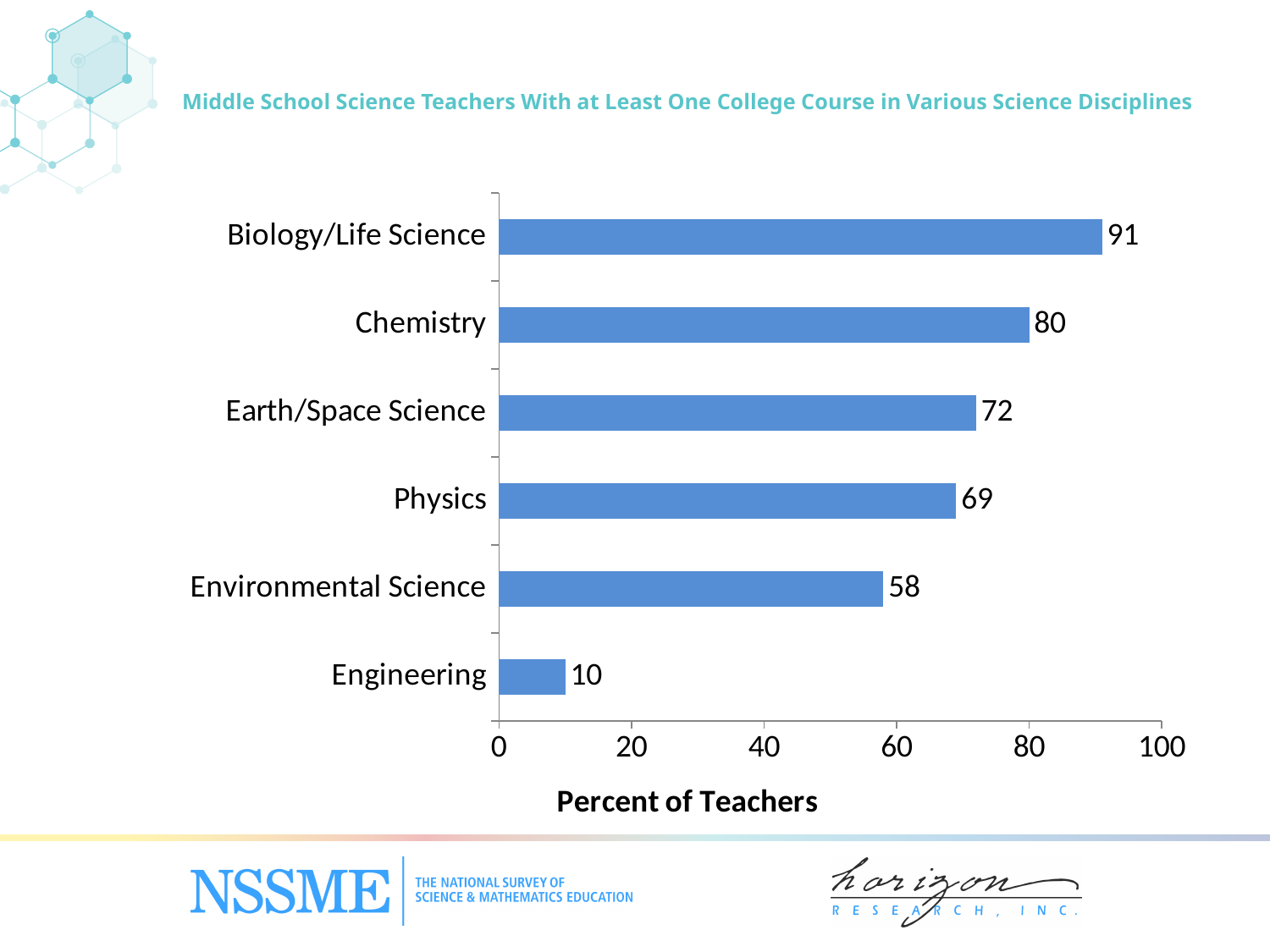
What is the difference between the values for Chemistry and Physics? 11 What is the value shown for Environmental Science? 58 What kind of chart is shown on the slide? Bar chart What is the label of the horizontal axis? Percent of Teachers What is the value shown for Chemistry? 80 What percent of teachers have at least one college course in Biology/Life Science? 91 Which is larger, the value for Earth/Space Science or the value for Environmental Science? Earth/Space Science Is the value for Physics greater or less than 60? greater Which discipline has the lowest percent of teachers? Engineering Which discipline has the highest percent of teachers? Biology/Life Science What is the difference between the values for Biology/Life Science and Engineering? 81 How many disciplines are shown in the chart? 6